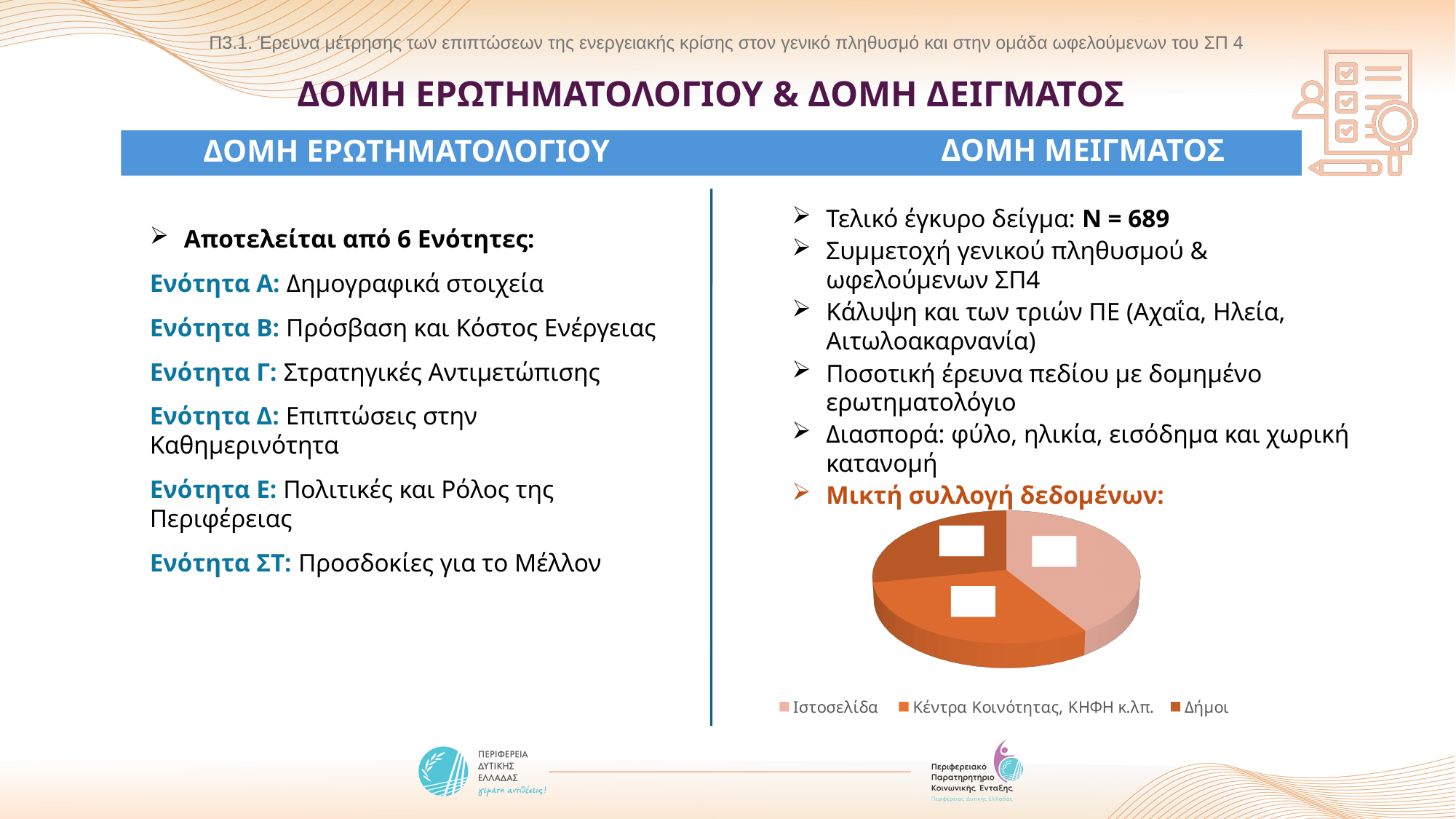
Which slice is larger in the pie chart, Ιστοσελίδα or Δήμοι? Ιστοσελίδα Which legend entry of the pie chart is shown in the lightest (pink) colour? Ιστοσελίδα What are the three legend entries of the pie chart? Ιστοσελίδα, Κέντρα Κοινότητας, ΚΗΦΗ κ.λπ., Δήμοι Which category has the largest slice in the pie chart? Ιστοσελίδα How many slices does the pie chart have? 3 How many entries does the legend of the pie chart list? 3 What kind of chart is shown on the slide? pie chart